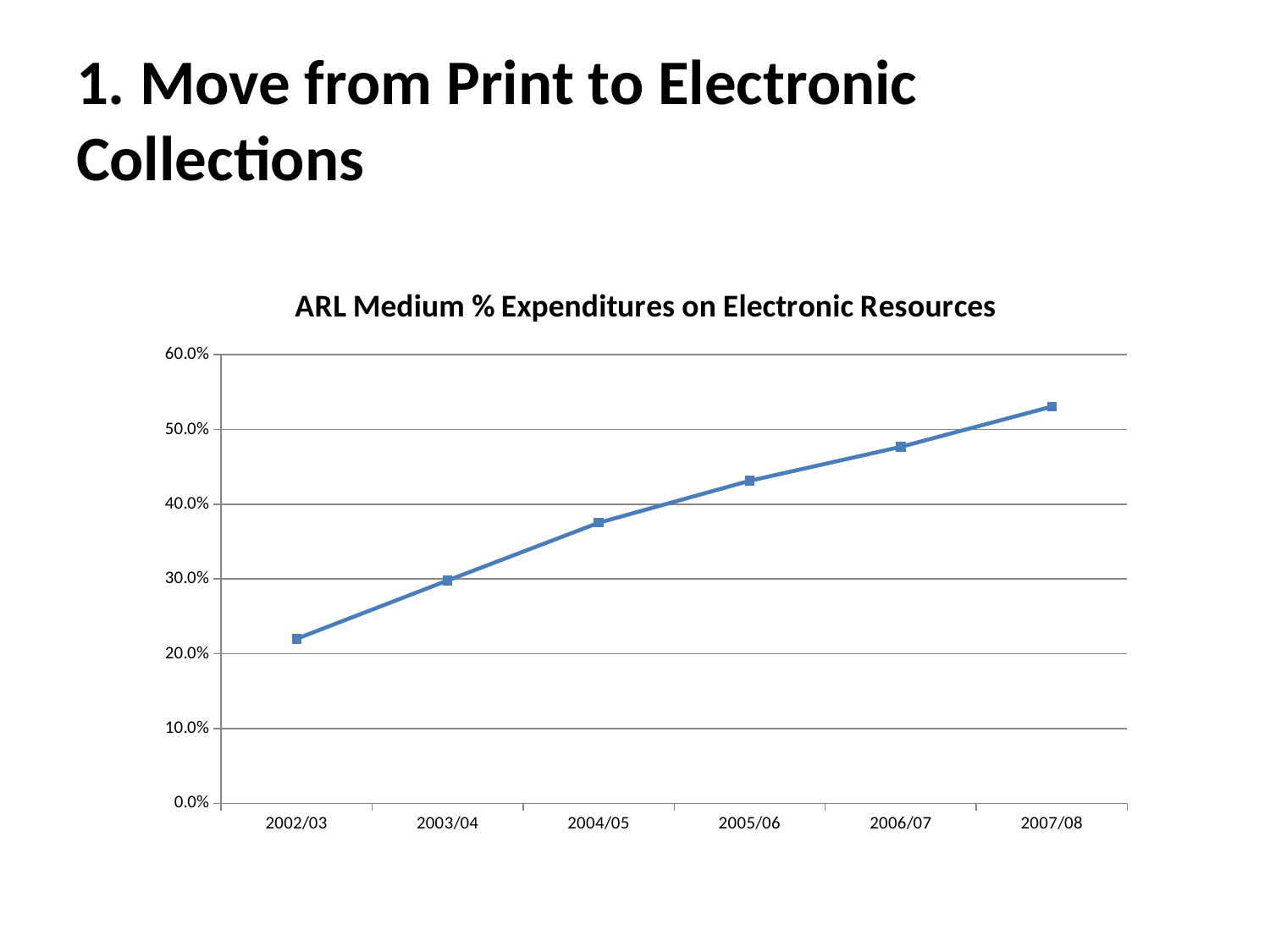
What type of chart is shown on the slide? line chart Is the value for 2007/08 greater or less than 50.0%? greater Which year has the highest value? 2007/08 Is the value for 2005/06 greater or less than 40.0%? greater What is the title of the chart? ARL Medium % Expenditures on Electronic Resources How many data points are plotted on the chart? 6 What is the first year shown on the x axis? 2002/03 Which is larger, the value for 2003/04 or the value for 2006/07? 2006/07 Which year has the lowest value? 2002/03 Is the value for 2002/03 greater or less than 30.0%? less Do the values rise or fall from 2002/03 to 2007/08? rise